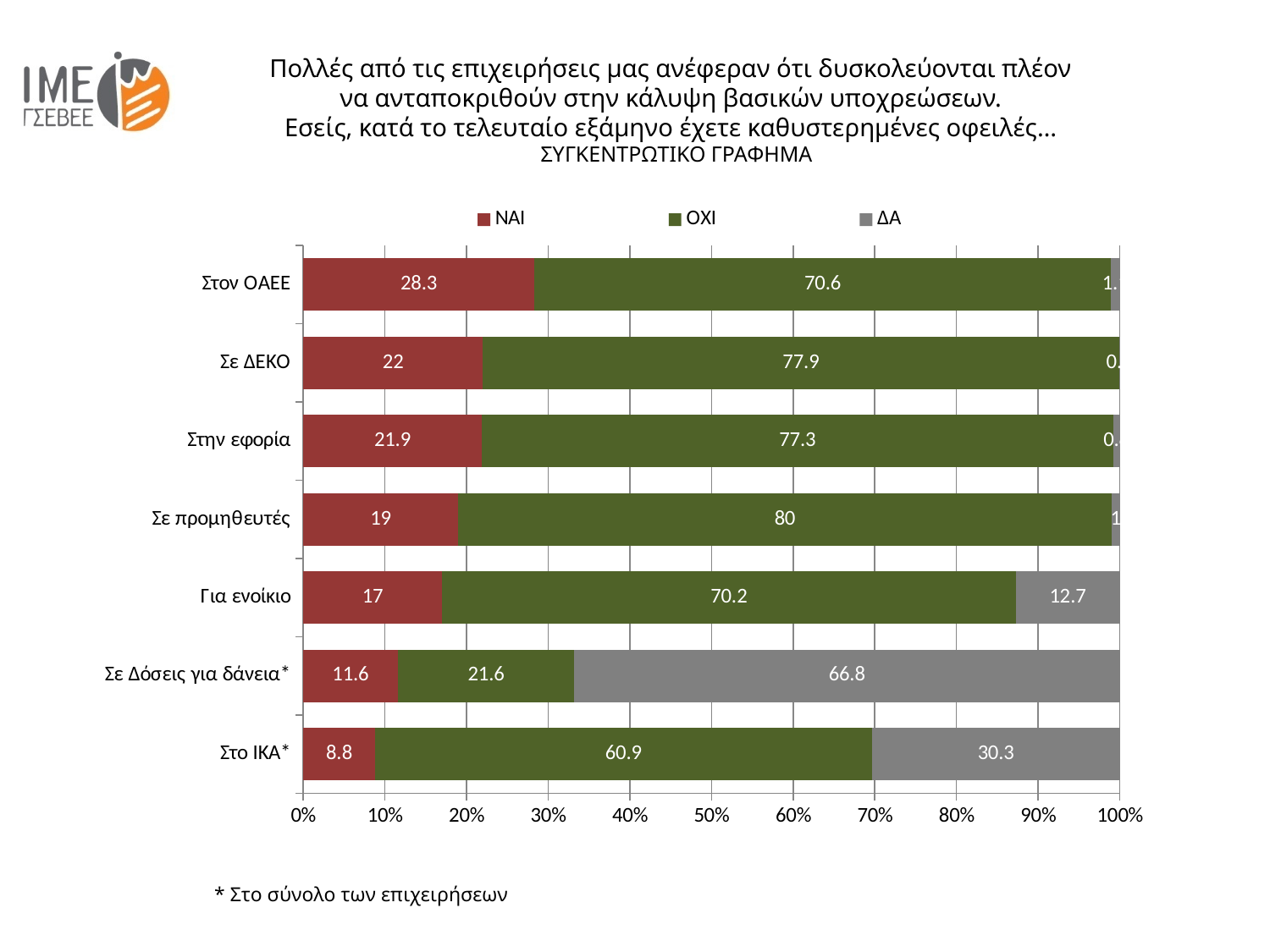
Which category has the highest ΟΧΙ value? Σε προμηθευτές How many categories are shown on the chart? 7 What is the ΔΑ value for Σε Δόσεις για δάνεια*? 66.8 What is the ΟΧΙ value for Σε προμηθευτές? 80 Which category has the highest ΝΑΙ value? Στον ΟΑΕΕ Which has the larger ΔΑ value, Στο ΙΚΑ* or Για ενοίκιο? Στο ΙΚΑ* Which category has the lowest ΝΑΙ value? Στο ΙΚΑ* What is the ΝΑΙ value for Στον ΟΑΕΕ? 28.3 What is the ΟΧΙ value for Στο ΙΚΑ*? 60.9 How many series does the legend list? 3 What is the difference between the ΝΑΙ values for Στον ΟΑΕΕ and Σε ΔΕΚΟ? 6.3 What kind of chart is shown on the slide? Stacked bar chart